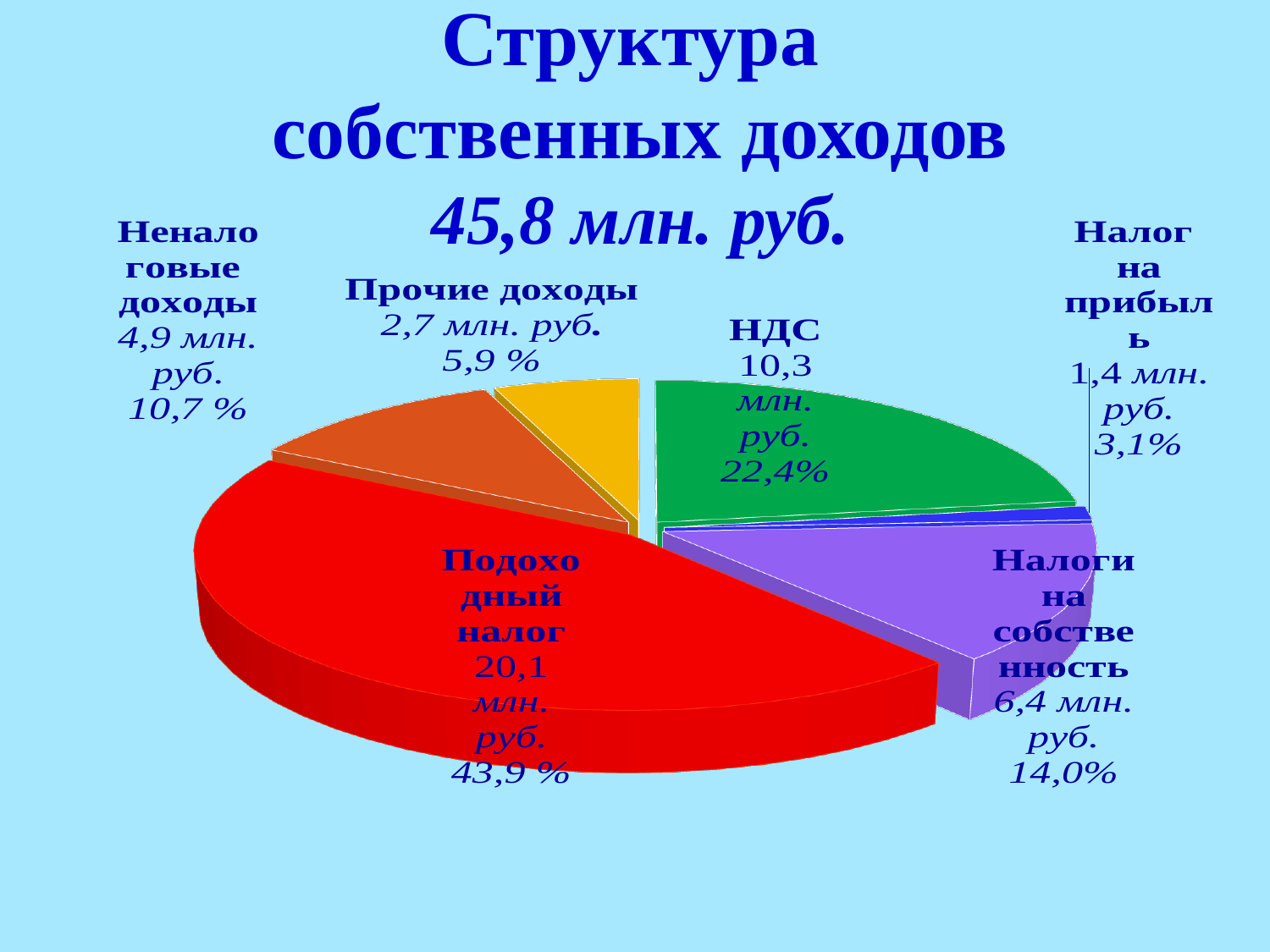
What is the value for Налоги на собственность in млн. руб.? 6,4 млн. руб. How many slices does the pie chart have? 6 What total amount of own revenues is stated in the chart title? 45,8 млн. руб. What is the value for Прочие доходы in млн. руб.? 2,7 млн. руб. Which category has the largest slice of the pie? Подоходный налог What share of the pie does НДС represent? 22,4% What is the difference in млн. руб. between Подоходный налог and НДС? 9,8 млн. руб. What is the value for Подоходный налог in млн. руб.? 20,1 млн. руб. Which category has the smallest slice of the pie? Налог на прибыль Which is larger, Налоги на собственность or Неналоговые доходы? Налоги на собственность What kind of chart is shown on the slide? Pie chart What percentage share is shown for Неналоговые доходы? 10,7 %